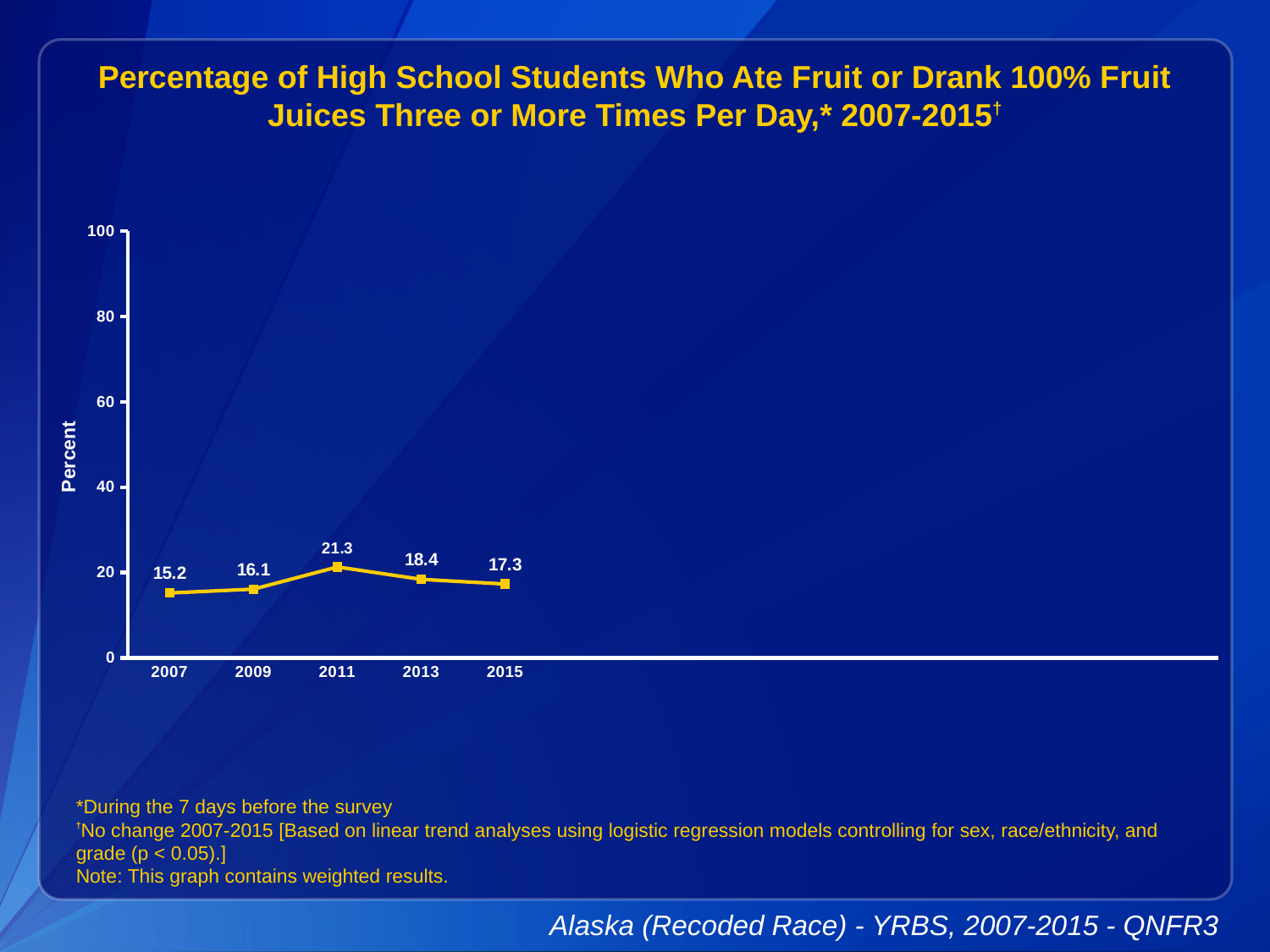
What was the percentage of high school students who ate fruit or drank 100% fruit juices three or more times per day in 2007? 15.2 What value is shown for 2015? 17.3 Which year has the lowest value? 2007 Is the value for 2011 greater or less than 20? greater What kind of chart is shown on the slide? line chart How many years are plotted on the chart? 5 What is the label on the y axis? Percent Did the value rise or fall from 2011 to 2015? fall What is the difference between the values for 2011 and 2015? 4.0 Which is larger, the value for 2013 or the value for 2009? 2013 What value is shown for 2011? 21.3 Which year has the highest value? 2011